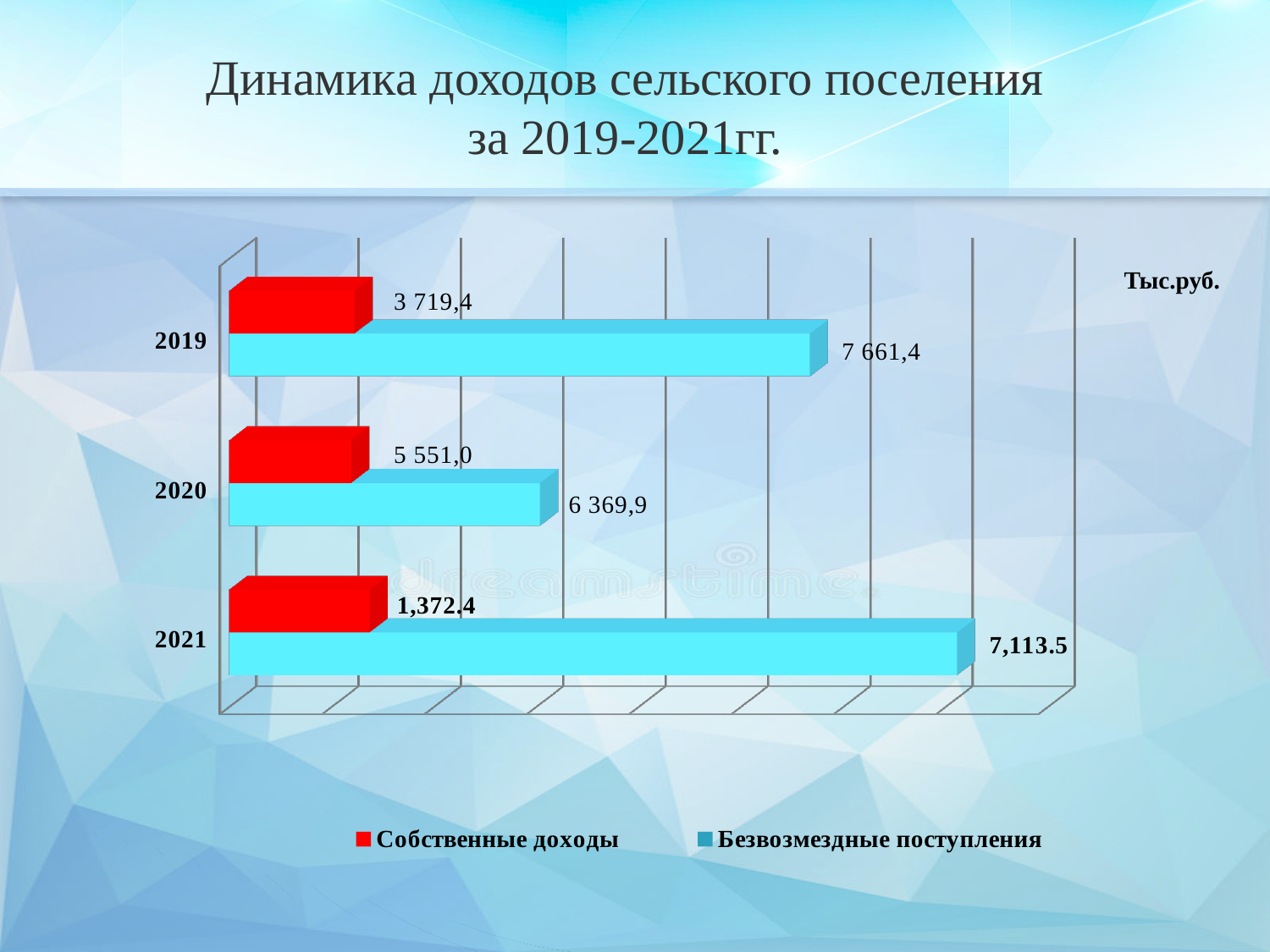
What unit of measurement is indicated on the chart? Тыс.руб. In 2020, which is larger: Собственные доходы or Безвозмездные поступления? Безвозмездные поступления What is the value of Безвозмездные поступления for 2021? 7,113.5 How many years (categories) are shown on the chart? 3 What is the value of Собственные доходы for 2019? 3 719,4 How many series does the legend list? 2 What is the value of Безвозмездные поступления for 2020? 6 369,9 In which year is Безвозмездные поступления the lowest? 2020 What is the difference between Безвозмездные поступления and Собственные доходы in 2019? 3 942,0 What is the value of Собственные доходы for 2021? 1,372.4 What type of chart is shown on the slide? bar chart